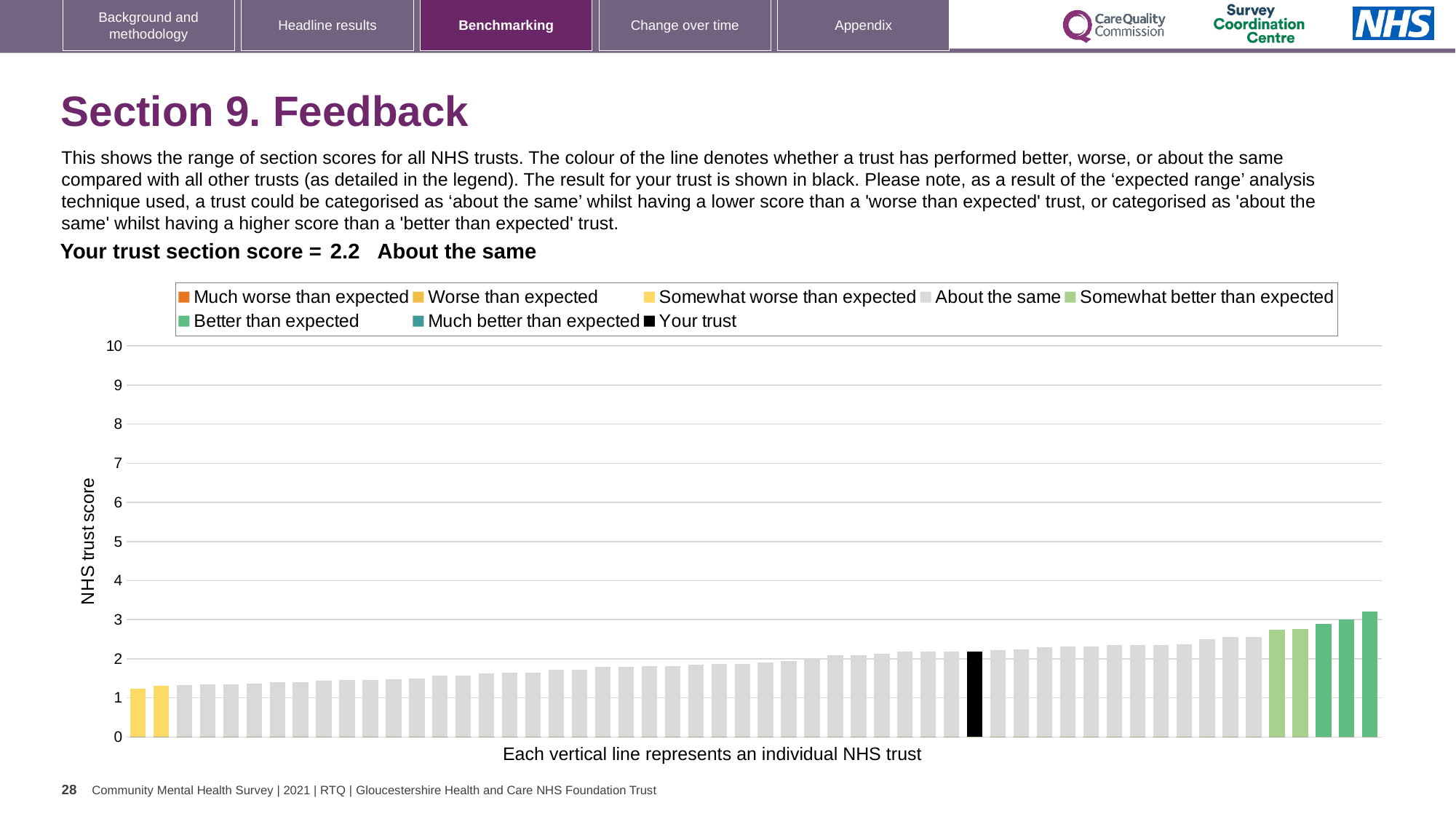
Do the bar values rise or fall from left to right along the x axis? rise What is the label on the vertical axis of the chart? NHS trust score What kind of chart is shown on the slide? bar chart What is the highest value shown on the vertical axis? 10 Is the value of the tallest bar greater or less than 3? greater Which category is your trust's section score placed in? About the same Is the value of the shortest bar greater or less than 1? greater Is the value of the black bar (your trust) greater or less than 3? less What is the section score for your trust shown on the slide? 2.2 How many yellow 'Somewhat worse than expected' bars are shown in the chart? 2 How many entries does the chart legend list? 8